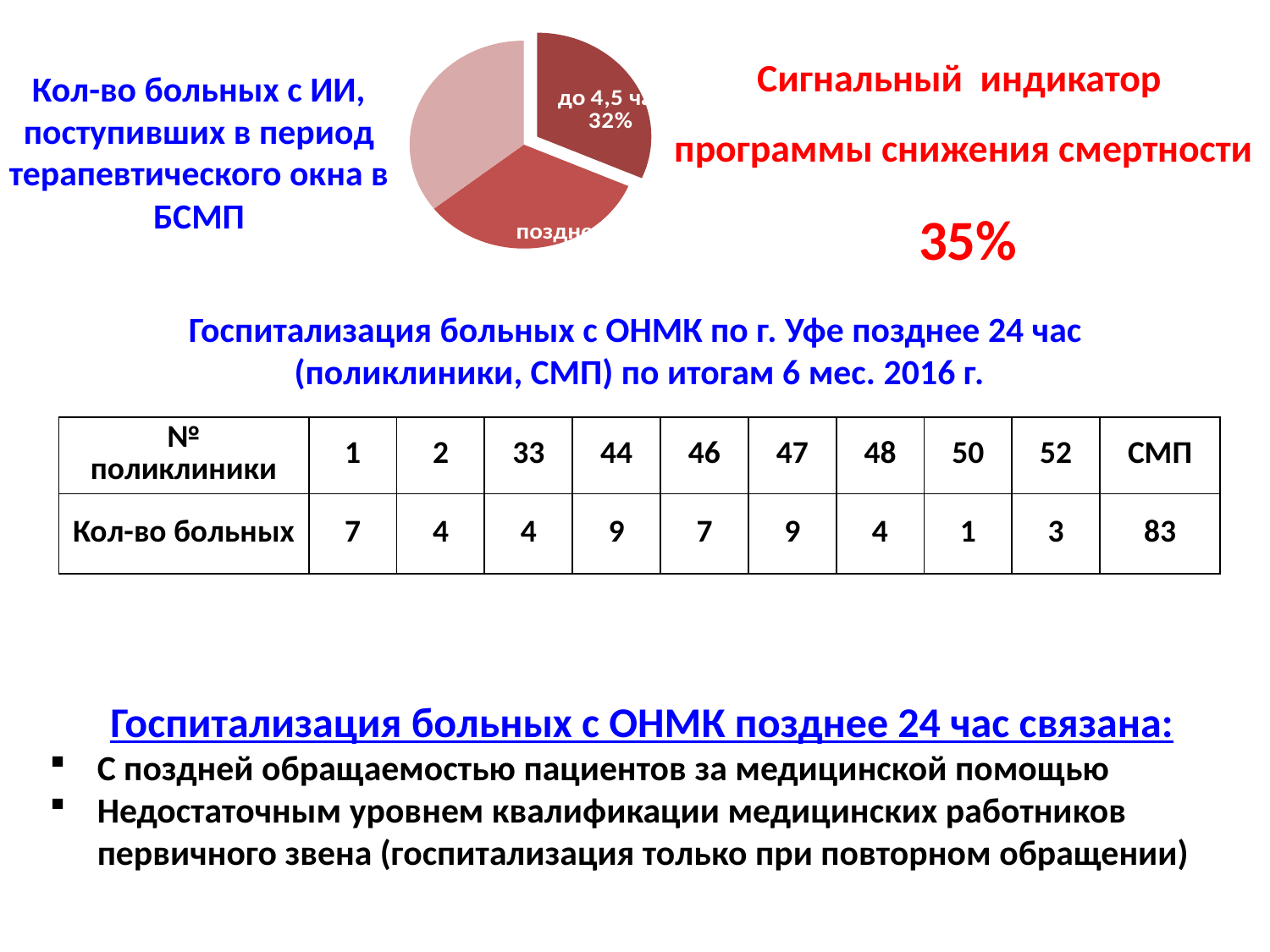
What is the title text shown to the left of the pie chart? Кол-во больных с ИИ, поступивших в период терапевтического окна в БСМП Which slice of the pie chart is labelled with 32%? до 4,5 ча… What kind of chart is shown at the top of the slide? pie chart What share of the pie does the slice labelled "до 4,5 ча…" represent? 32% How many slices does the pie chart have? 3 What colour is the slice of the pie chart labelled 32%? dark red